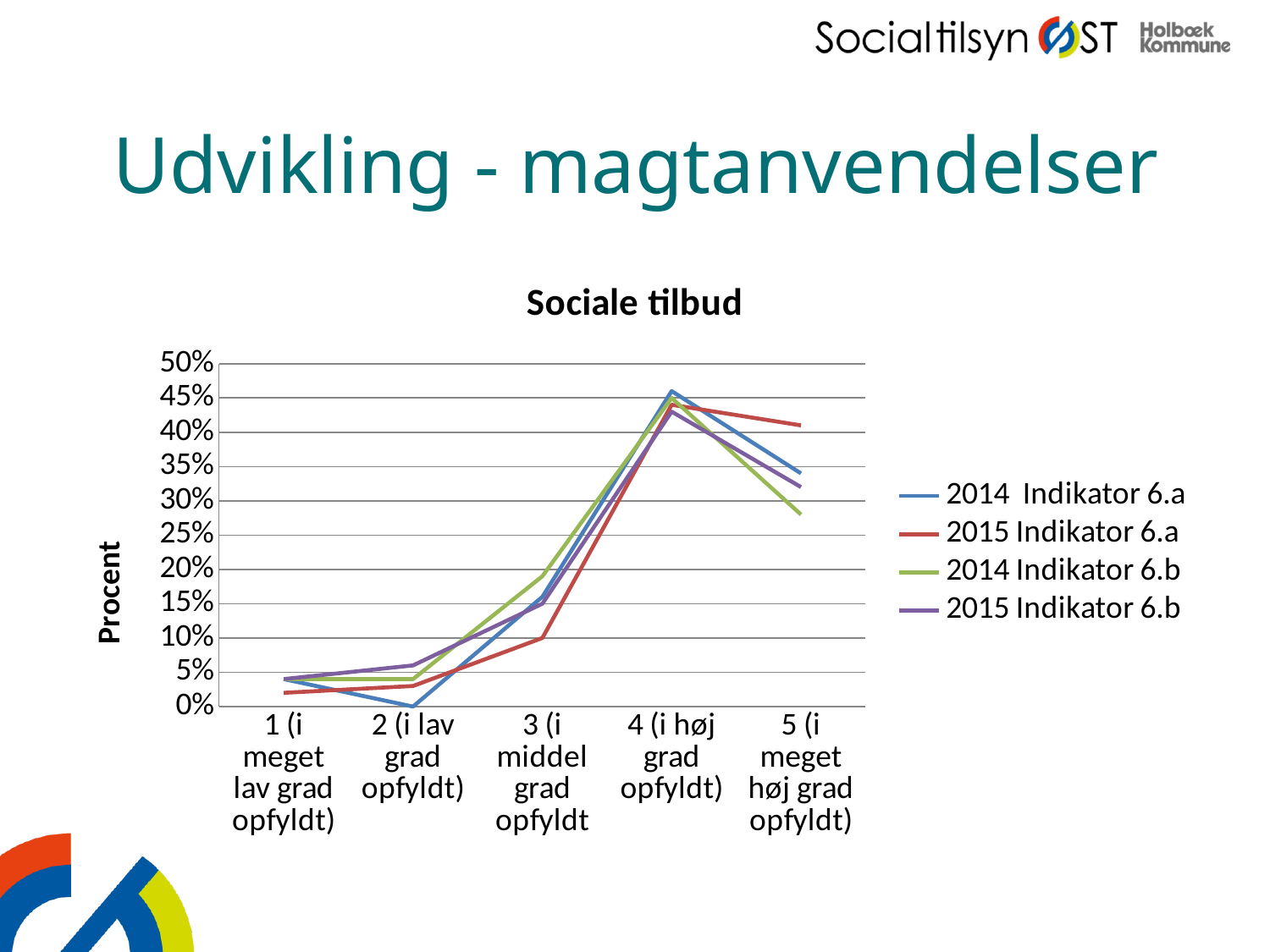
What kind of chart is shown under the title "Sociale tilbud"? line chart How many categories are shown on the x axis of the "Sociale tilbud" chart? 5 How many series does the legend of the "Sociale tilbud" chart list? 4 Is the value for 2015 Indikator 6.a at "3 (i middel grad opfyldt)" greater or less than 15%? less At "5 (i meget høj grad opfyldt)", which series has the higher value: 2015 Indikator 6.a or 2014 Indikator 6.b? 2015 Indikator 6.a Which series has the highest value at "5 (i meget høj grad opfyldt)"? 2015 Indikator 6.a Is the value for 2014 Indikator 6.b at "3 (i middel grad opfyldt)" greater or less than 15%? greater For the series 2014 Indikator 6.a, which category has the highest value? 4 (i høj grad opfyldt) Does the 2015 Indikator 6.a line rise or fall from "1 (i meget lav grad opfyldt)" to "4 (i høj grad opfyldt)"? rise What is the label on the vertical axis of the "Sociale tilbud" chart? Procent Is the value for 2015 Indikator 6.a at "5 (i meget høj grad opfyldt)" greater or less than 35%? greater For the series 2014 Indikator 6.a, which category has the lowest value? 2 (i lav grad opfyldt)